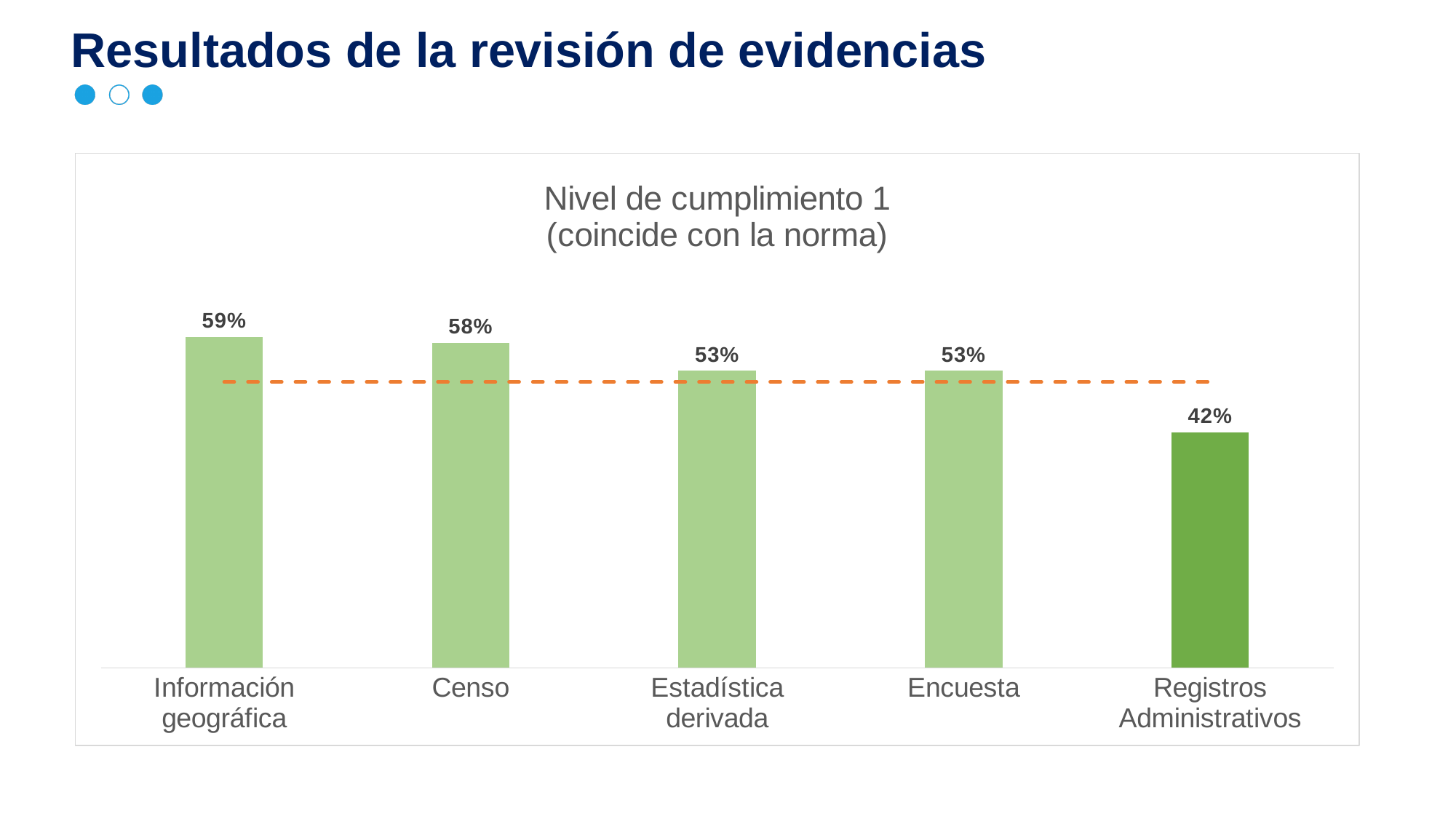
What is the value for Encuesta? 53% What is the value for Información geográfica? 59% What kind of chart is shown on the slide? Bar chart Which category has the highest value? Información geográfica What is the value for Censo? 58% What is the difference between the values for Información geográfica and Registros Administrativos? 17% Which category has the lowest value? Registros Administrativos How many categories are shown in the chart? 5 What is the value for Registros Administrativos? 42% What is the title of the chart? Nivel de cumplimiento 1 (coincide con la norma) What is the difference between the values for Censo and Estadística derivada? 5% Which is larger, the value for Censo or the value for Encuesta? Censo